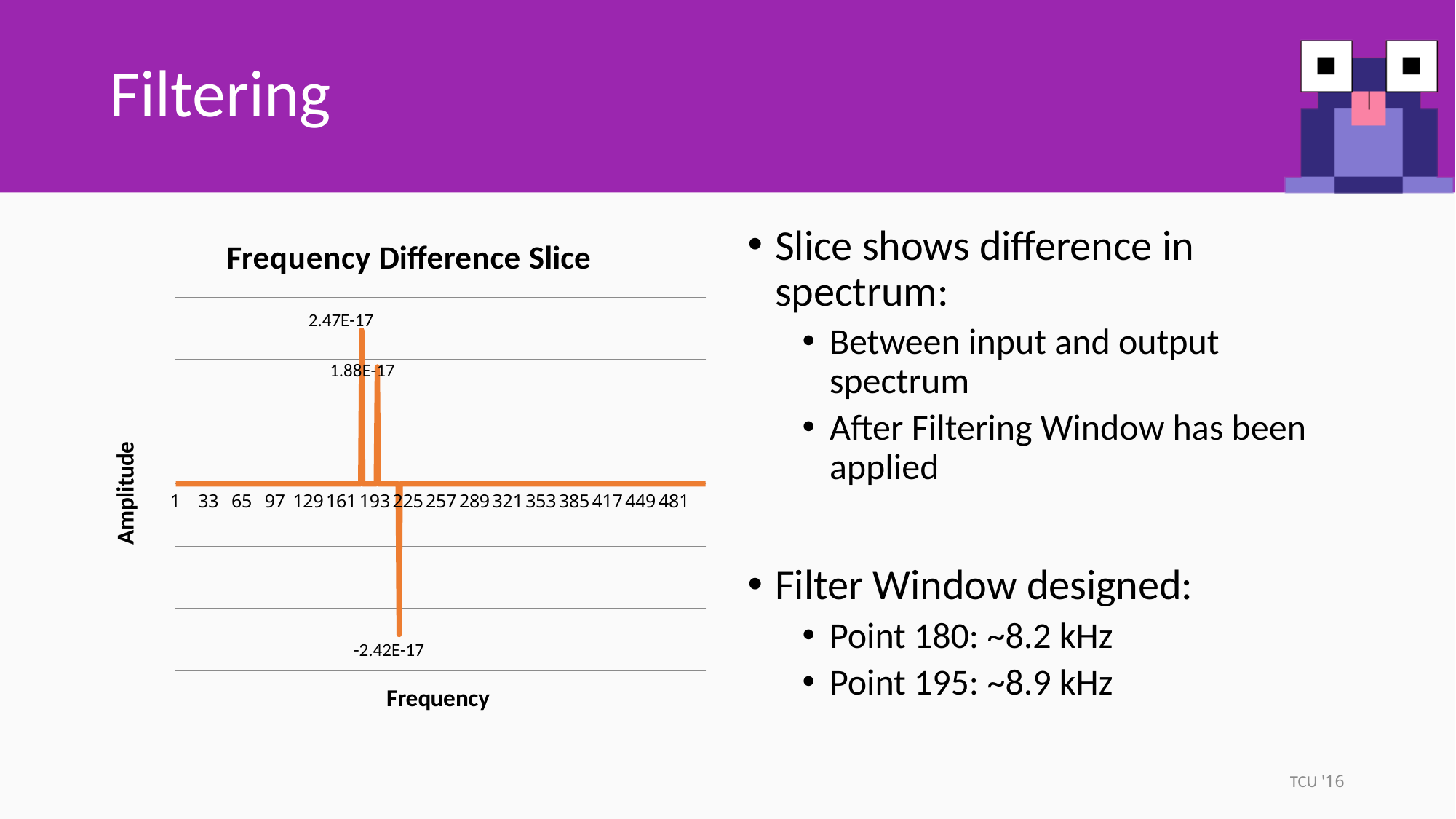
What is the first tick label on the Frequency axis? 1 What type of chart is shown on the slide? line chart What is the lowest data-labelled value on the chart? -2.42E-17 What is the last tick label on the Frequency axis? 481 How many tick labels are shown along the Frequency axis? 16 Which labelled positive spike is larger, the one labelled 2.47E-17 or the one labelled 1.88E-17? 2.47E-17 What is the label of the vertical axis of the chart? Amplitude What is the value of the second, smaller positive spike labelled on the chart? 1.88E-17 Is the labelled negative spike value -2.42E-17 greater or less than 0? less What is the highest data-labelled value on the chart? 2.47E-17 What is the title of the chart? Frequency Difference Slice